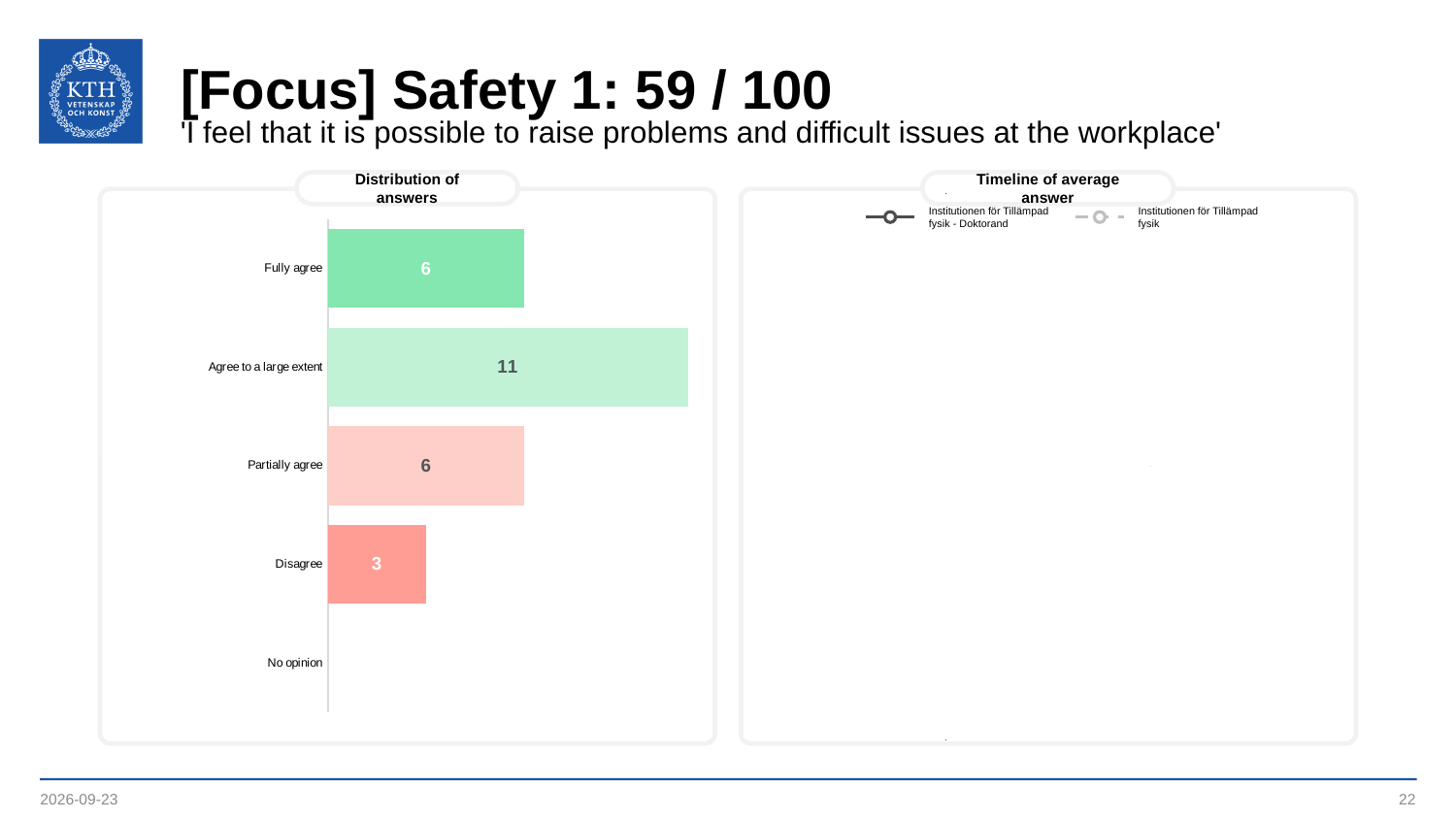
In the 'Distribution of answers' chart, what is the difference between 'Agree to a large extent' and 'Fully agree'? 5 In the 'Distribution of answers' chart, which answer category has the highest value? Agree to a large extent In the 'Distribution of answers' chart, what is the difference between 'Agree to a large extent' and 'Disagree'? 8 How many answer categories are listed in the 'Distribution of answers' chart? 5 How many series does the legend of the 'Timeline of average answer' chart list? 2 What type of chart is the 'Distribution of answers' chart? Bar chart In the 'Distribution of answers' chart, how many respondents chose 'Agree to a large extent'? 11 In the 'Distribution of answers' chart, which is larger: 'Partially agree' or 'Disagree'? Partially agree In the 'Distribution of answers' chart, what is the value for 'Disagree'? 3 In the 'Distribution of answers' chart, what is the value for 'Fully agree'? 6 What is the title of the chart on the left side of the slide? Distribution of answers In the 'Distribution of answers' chart, what is the value for 'Partially agree'? 6